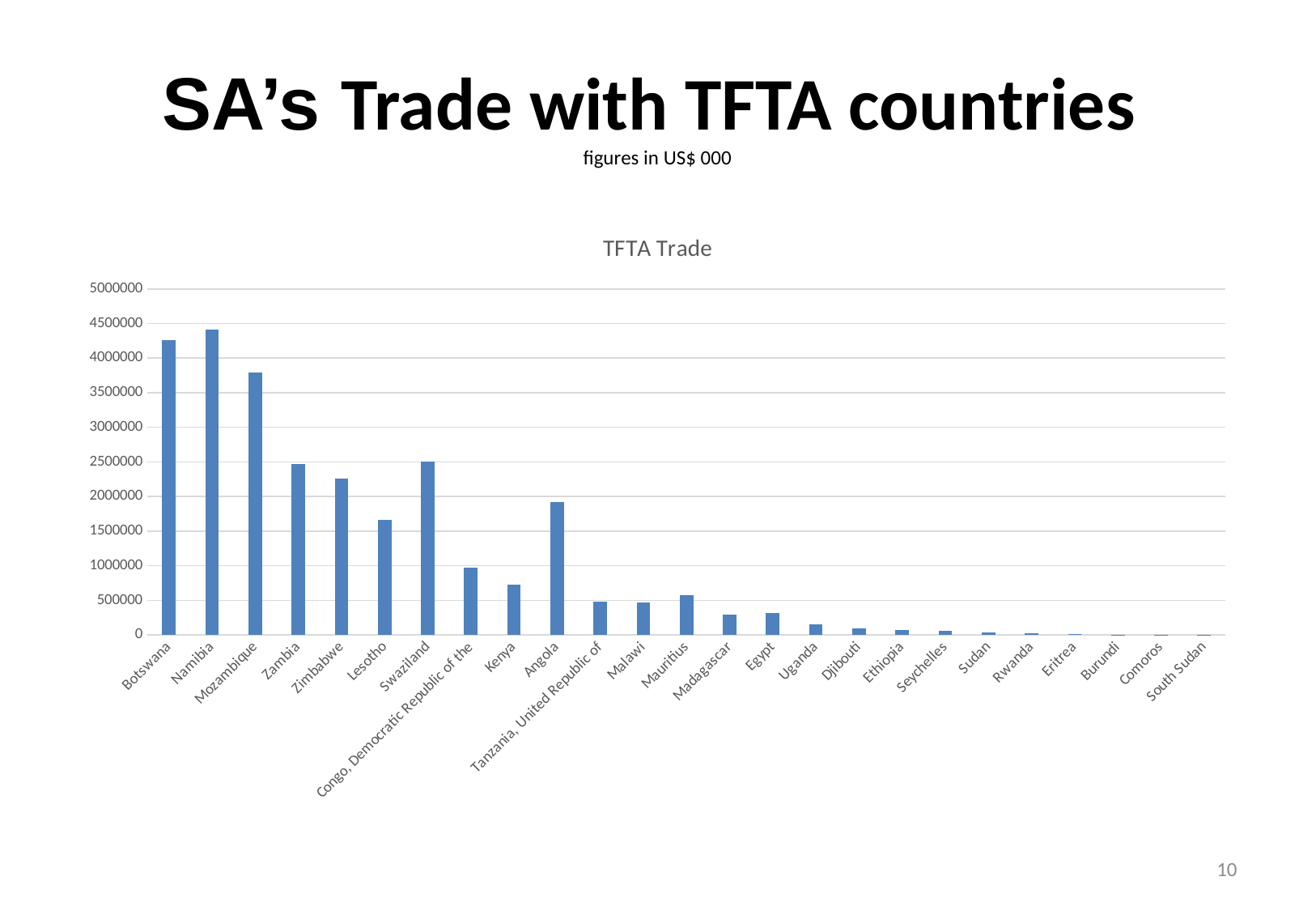
Which is larger, the value for Mozambique or the value for Zambia? Mozambique Is the value for Mozambique greater or less than 4000000? less Is the value for Lesotho greater or less than 1500000? greater What kind of chart is shown on the slide? bar chart Which is larger, the value for Swaziland or the value for Lesotho? Swaziland Is the value for Angola greater or less than 2000000? less Which country has the highest trade value in the chart? Namibia Do the values generally rise or fall moving from left to right along the x axis? fall How many countries are shown on the x axis of the chart? 25 What is the title of the chart? TFTA Trade